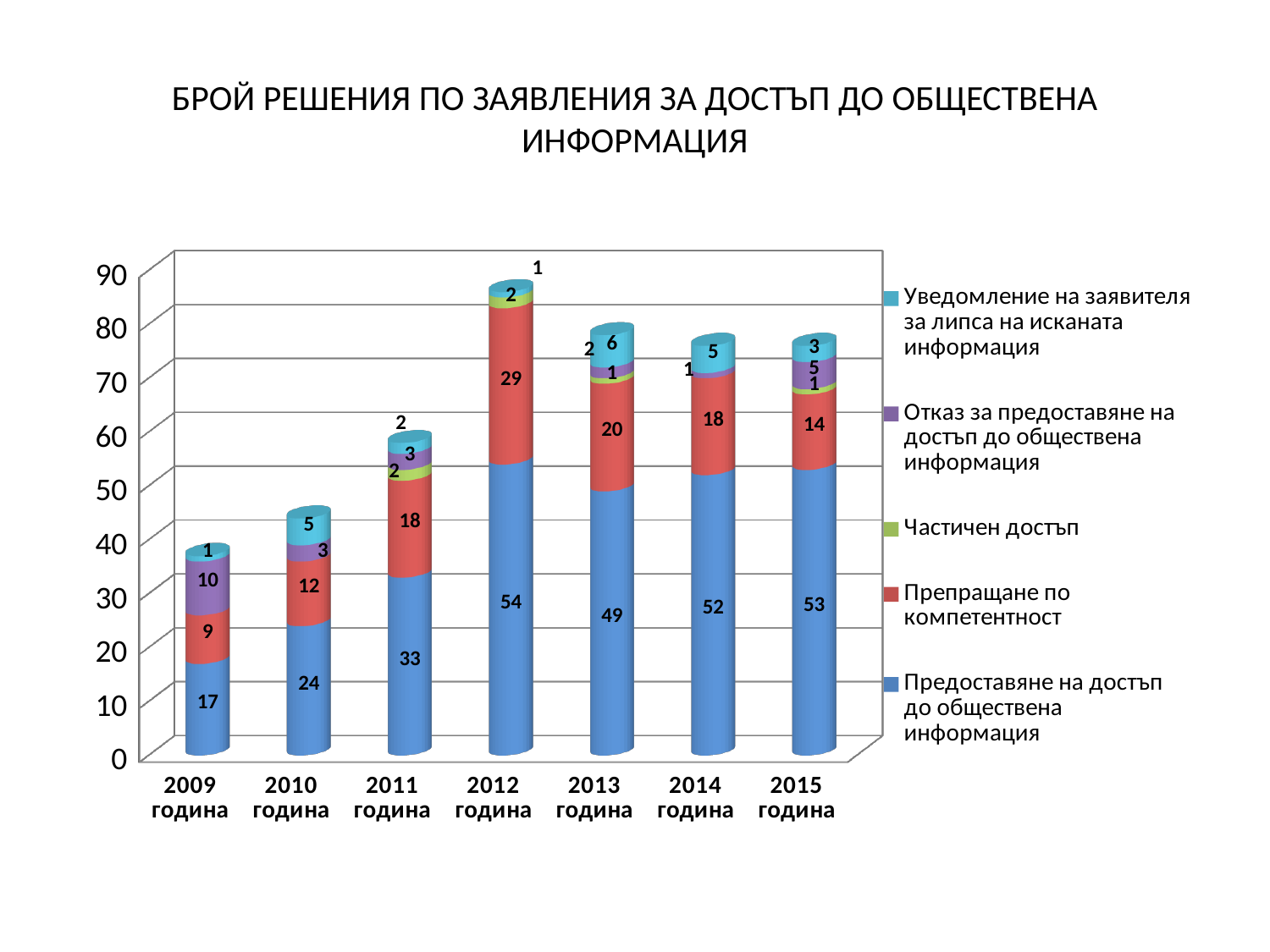
What is the value for "Предоставяне на достъп до обществена информация" in 2012 година? 54 Which year has the larger value for "Предоставяне на достъп до обществена информация": 2014 година or 2015 година? 2015 година In which year is the value for "Предоставяне на достъп до обществена информация" the lowest? 2009 година In which year is the value for "Предоставяне на достъп до обществена информация" the highest? 2012 година What kind of chart is shown on the slide? Stacked bar chart What is the value for "Препращане по компетентност" in 2011 година? 18 What is the difference between the "Препращане по компетентност" values for 2012 година and 2013 година? 9 Does the value for "Предоставяне на достъп до обществена информация" rise or fall from 2009 година to 2012 година? Rise What is the total of the stacked bar for 2010 година? 44 What is the value for "Отказ за предоставяне на достъп до обществена информация" in 2009 година? 10 How many series does the legend list? 5 How many years are shown on the x axis? 7